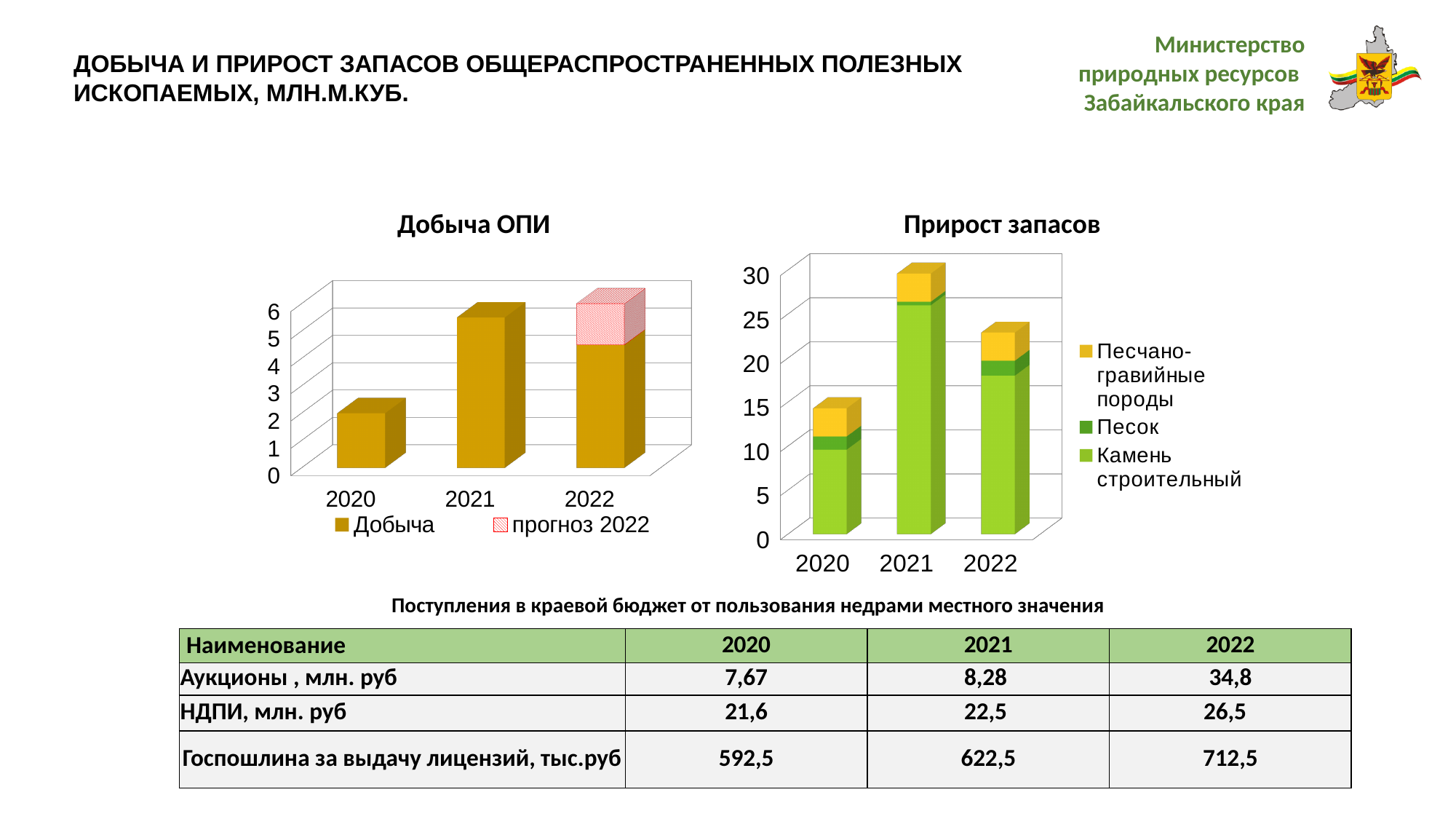
How many series does the legend of the "Добыча ОПИ" chart list? 2 In the "Добыча ОПИ" chart, is the value for Добыча in 2021 greater or less than 4? greater In the "Прирост запасов" chart, which year has the tallest stacked bar? 2021 How many years are shown on the x axis of the "Прирост запасов" chart? 3 In the "Добыча ОПИ" chart, is the value for Добыча in 2020 greater or less than 3? less What kind of chart is the "Прирост запасов" chart? stacked bar chart In the "Прирост запасов" chart, is the total stacked value for 2020 greater or less than 20? less In the "Добыча ОПИ" chart, which year has the highest value for Добыча? 2021 How many series does the legend of the "Прирост запасов" chart list? 3 What kind of chart is the "Добыча ОПИ" chart? bar chart In the "Прирост запасов" chart, which series is shown in yellow? Песчано-гравийные породы In the "Добыча ОПИ" chart, which year has the lowest value for Добыча? 2020